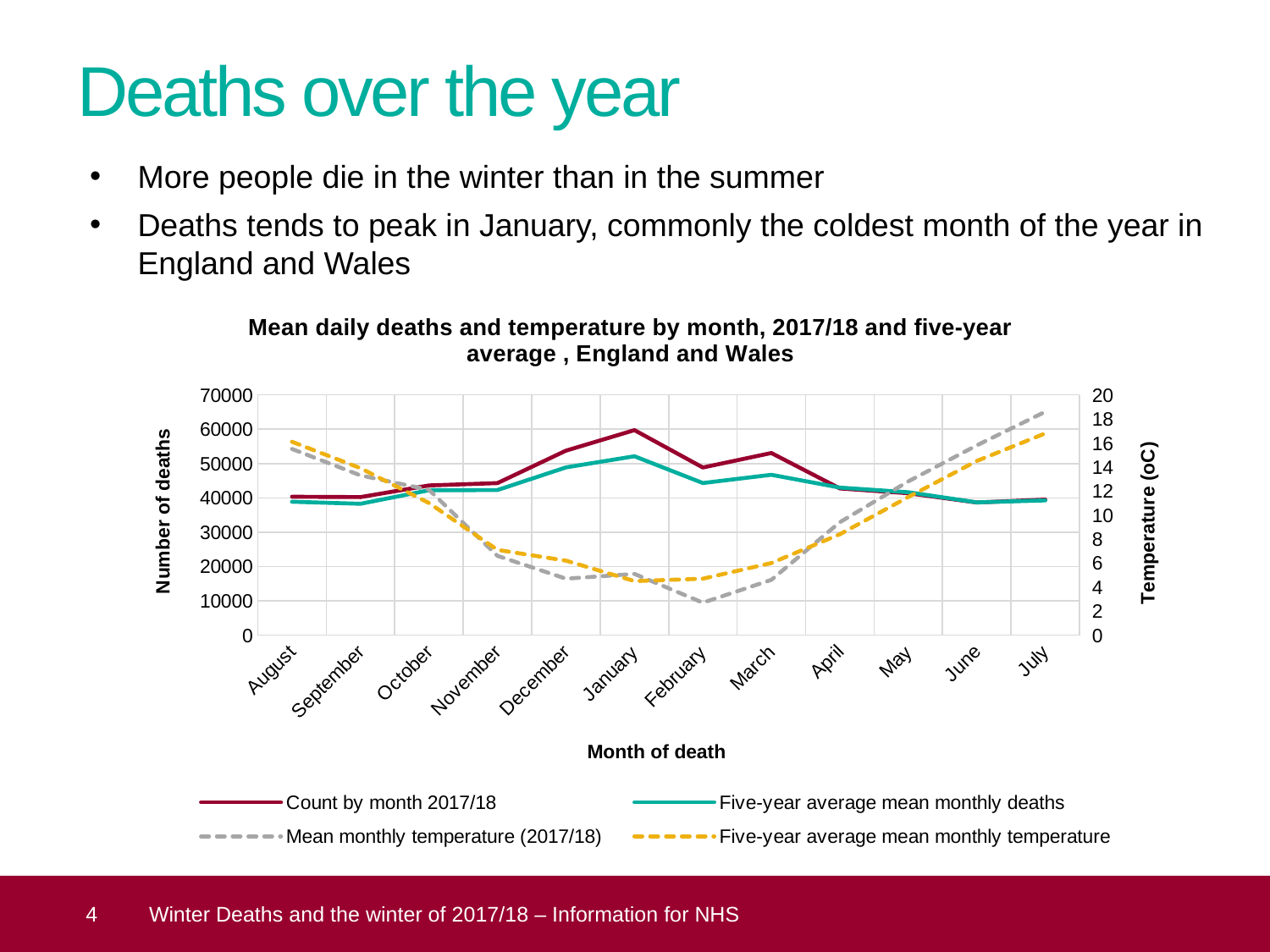
What is the title of the left vertical axis of the chart? Number of deaths Does the Count by month 2017/18 series rise or fall from January to February? fall Is the Mean monthly temperature (2017/18) in February greater or less than 6? less What kind of chart is shown on the slide? line chart Is the Five-year average mean monthly temperature in July greater or less than 14? greater In which month is the Mean monthly temperature (2017/18) series at its lowest? February How many series does the chart's legend list? 4 How many months are plotted along the x axis of the chart? 12 In which month does the Count by month 2017/18 series reach its highest value? January Is the value of Count by month 2017/18 in January greater or less than 50000? greater In January, which is higher: Count by month 2017/18 or Five-year average mean monthly deaths? Count by month 2017/18 In which month is the Mean monthly temperature (2017/18) series at its highest? July